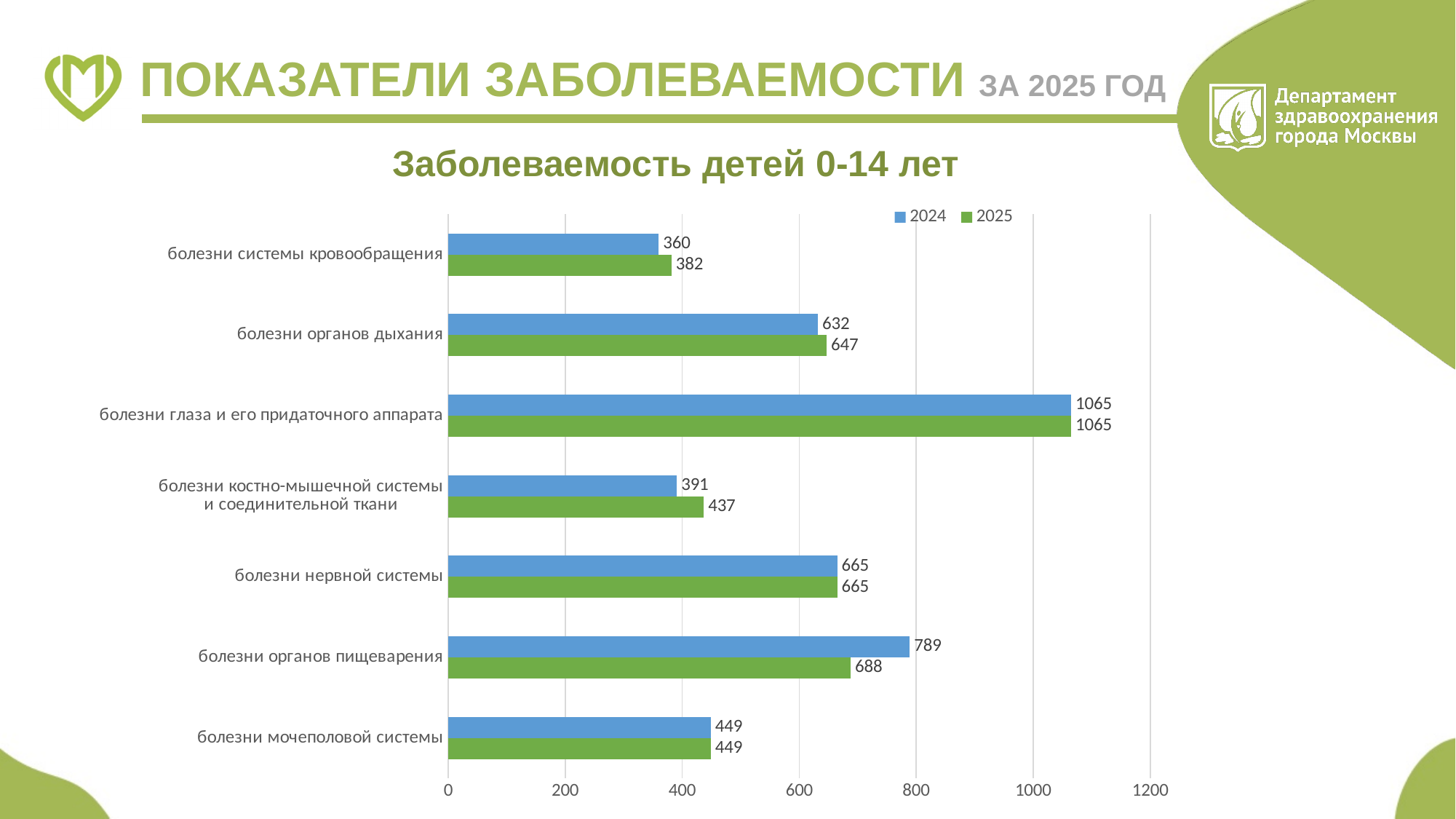
What type of chart is shown on the slide? bar chart How many series does the legend list? 2 How many disease categories are shown on the chart? 7 What is the 2025 value for болезни костно-мышечной системы и соединительной ткани? 437 What is the difference between the 2024 and 2025 values for болезни органов пищеварения? 101 What is the title of the chart? Заболеваемость детей 0-14 лет What is the 2025 value for болезни системы кровообращения? 382 What is the 2024 value for болезни органов пищеварения? 789 What is the difference between the 2025 and 2024 values for болезни костно-мышечной системы и соединительной ткани? 46 Which category has the lowest value in 2024? болезни системы кровообращения Which is larger for болезни органов дыхания: the 2024 value or the 2025 value? 2025 Which category has the highest value in 2025? болезни глаза и его придаточного аппарата